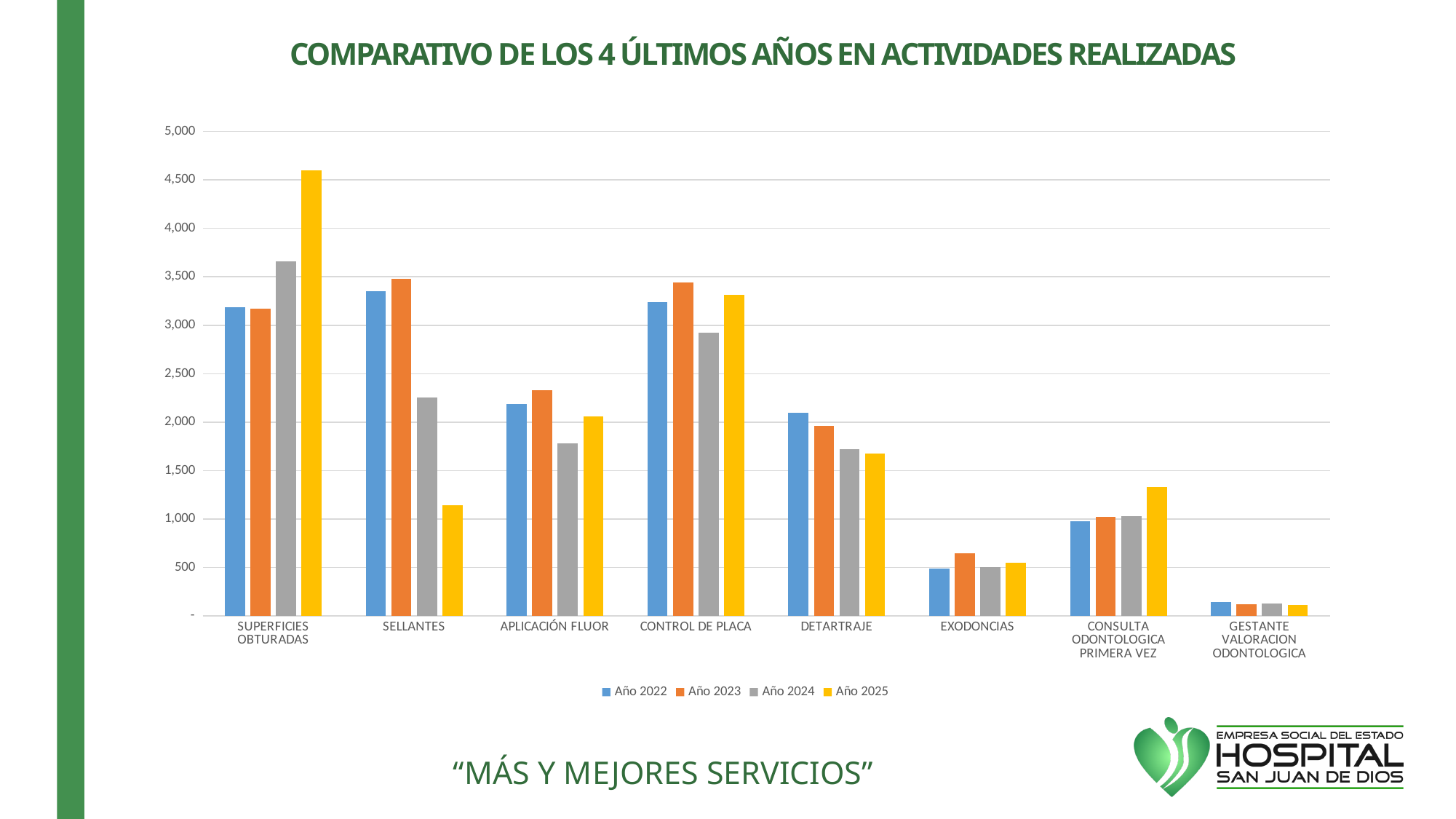
Is the Año 2025 value for SUPERFICIES OBTURADAS greater or less than 4,000? greater What kind of chart is shown on the slide? bar chart Is the Año 2023 value for EXODONCIAS greater or less than 500? greater Which category has the highest value for Año 2025? SUPERFICIES OBTURADAS For CONTROL DE PLACA, which is larger: the Año 2023 value or the Año 2024 value? Año 2023 Is the Año 2025 value for SELLANTES greater or less than 1,500? less Do the values for DETARTRAJE rise or fall from Año 2022 to Año 2025? fall For SELLANTES, which is larger: the Año 2022 value or the Año 2025 value? Año 2022 How many series does the legend list? 4 Which category has the lowest values across all four years? GESTANTE VALORACION ODONTOLOGICA What is the title of the chart? COMPARATIVO DE LOS 4 ÚLTIMOS AÑOS EN ACTIVIDADES REALIZADAS How many activity categories are shown on the x axis? 8